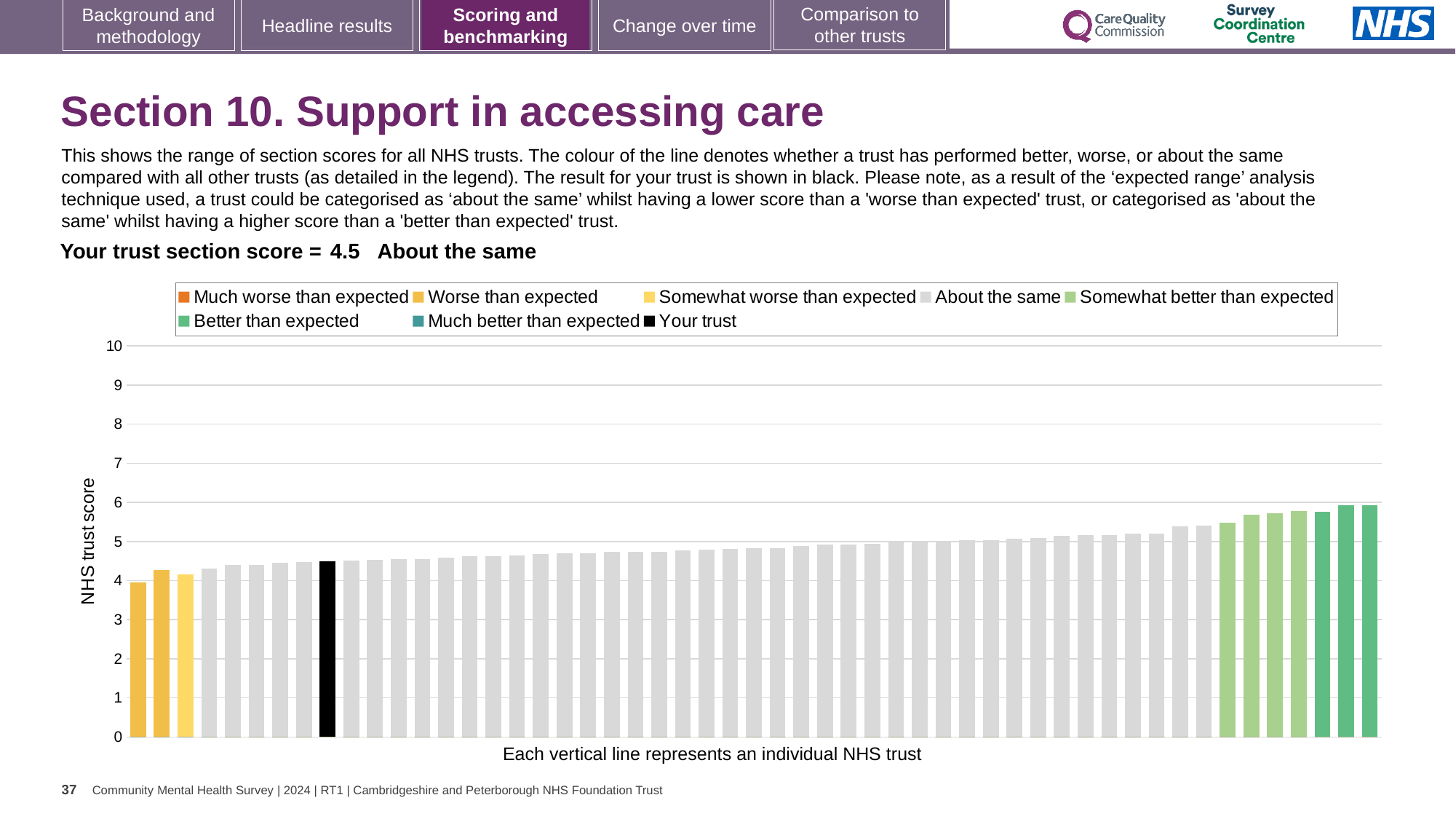
Is the value of the rightmost bar greater or less than 5? greater What is the section score for your trust shown on the slide? 4.5 Is the value of the leftmost bar greater or less than 5? less Which performance category is your trust placed in according to the slide? About the same How many bars in the chart are coloured black? 1 Do the bar values rise or fall from left to right across the chart? rise What type of chart is shown on the slide? bar chart Is the value of the black 'Your trust' bar greater or less than 5? less What is the label on the vertical axis of the chart? NHS trust score How many categories does the chart legend list? 8